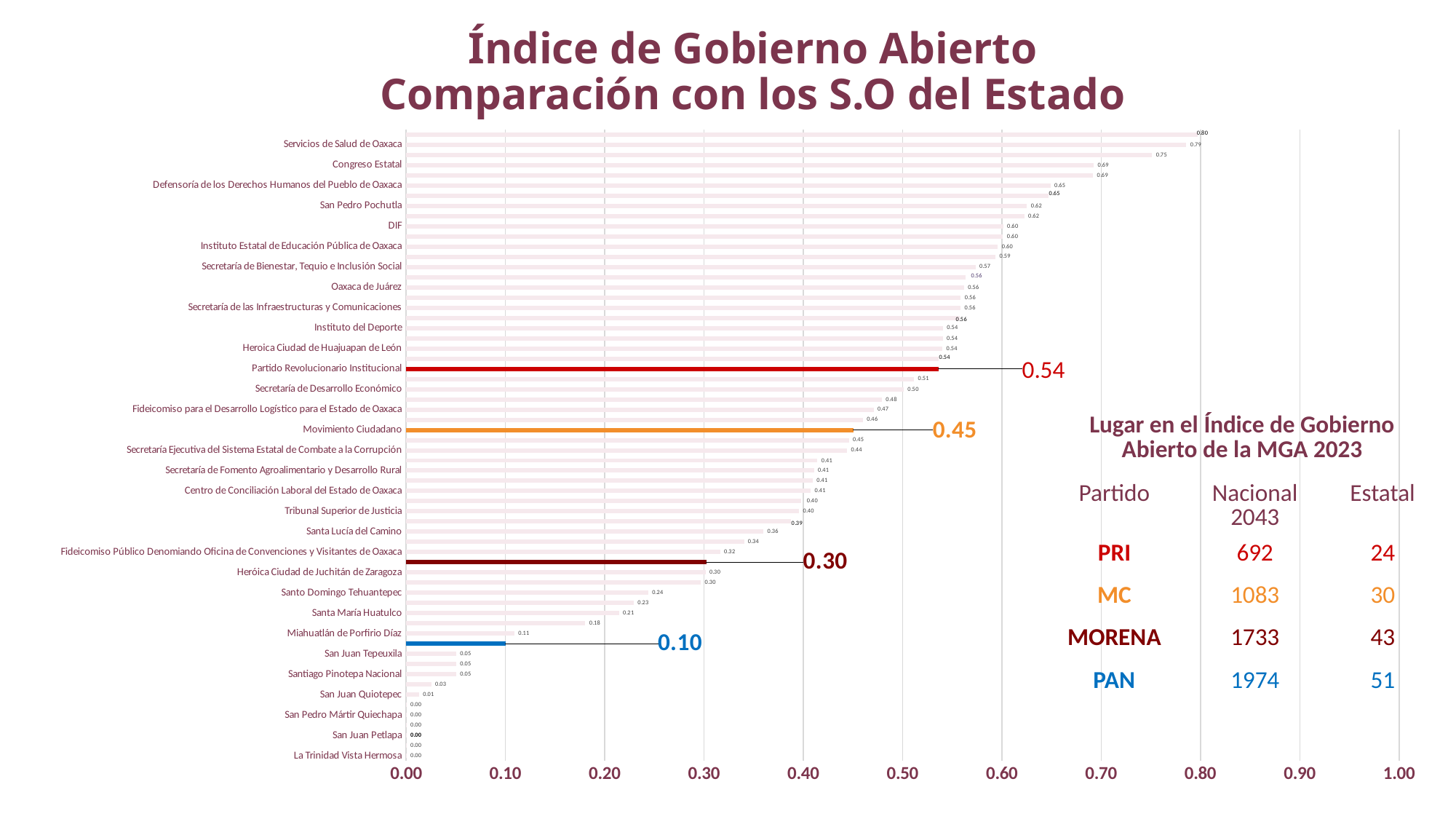
Are the bars ordered from highest to lowest or from lowest to highest going down the chart? Highest to lowest Is the value for Santa Lucía del Camino greater or less than 0.40? less What colour is the bar for Movimiento Ciudadano? Orange What is the value for Partido Revolucionario Institucional? 0.54 What is the value for Movimiento Ciudadano? 0.45 What value is labelled on the blue highlighted bar? 0.10 What is the value for La Trinidad Vista Hermosa? 0.00 What kind of chart is shown on the slide? Bar chart What is the difference between the values for Partido Revolucionario Institucional and Movimiento Ciudadano? 0.09 What is the value for Miahuatlán de Porfirio Díaz? 0.11 Which has the larger value, Partido Revolucionario Institucional or Movimiento Ciudadano? Partido Revolucionario Institucional Is the value for Servicios de Salud de Oaxaca greater or less than 0.70? greater